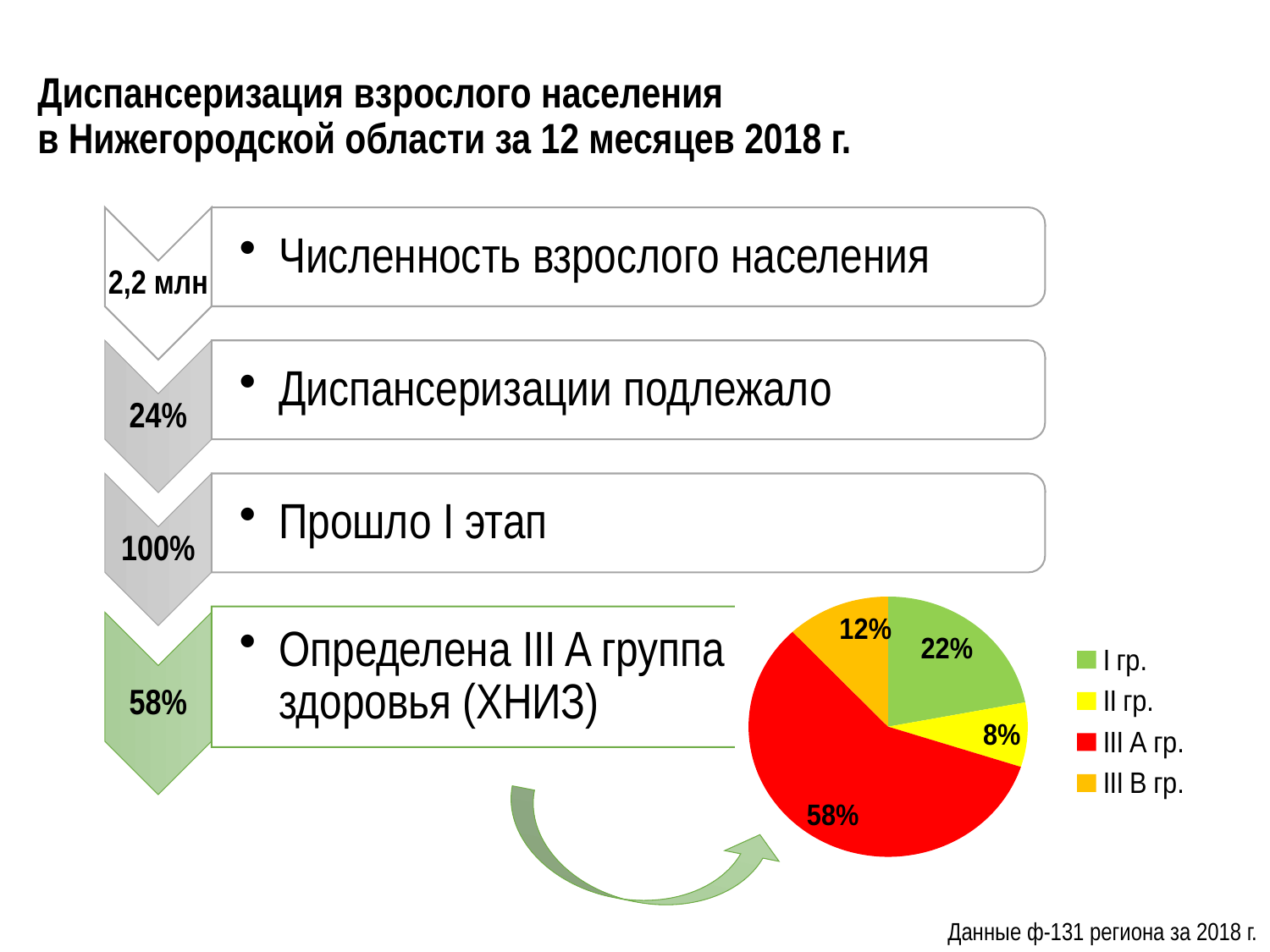
In the pie chart, what is the share for II гр.? 8% How many slices does the pie chart have? 4 Which group has the smallest slice in the pie chart? II гр. In the pie chart, what is the share for III А гр.? 58% Which group has the largest slice in the pie chart? III А гр. In the pie chart, what is the share for I гр.? 22% How many entries does the pie chart legend list? 4 What colour is the III А гр. slice in the pie chart? red What is the difference in percentage points between III А гр. and I гр. in the pie chart? 36 What kind of chart is shown on the slide? pie chart